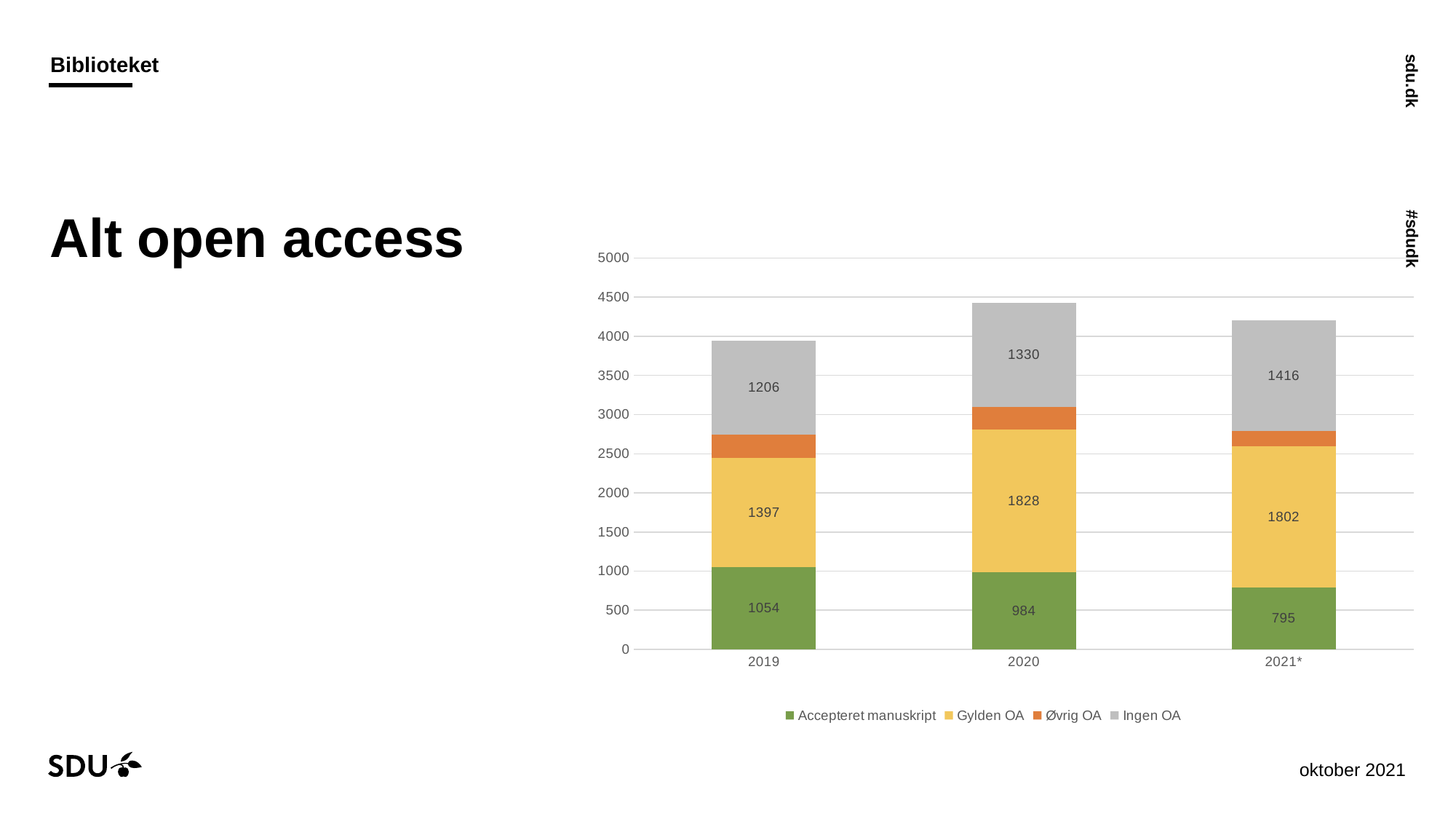
Which year has the lowest value for Accepteret manuskript? 2021* What is the value for Ingen OA in 2021*? 1416 How many years are shown on the x axis? 3 How many series does the legend list? 4 Is the Gylden OA value larger in 2020 or in 2021*? 2020 Which year has the highest value for Ingen OA? 2021* What is the value for Gylden OA in 2020? 1828 What is the difference between the Gylden OA values for 2020 and 2019? 431 What kind of chart is shown on the slide? Stacked bar chart What is the value for Accepteret manuskript in 2019? 1054 Which series is shown in orange in the legend? Øvrig OA Does the value for Accepteret manuskript rise or fall from 2019 to 2021*? Fall